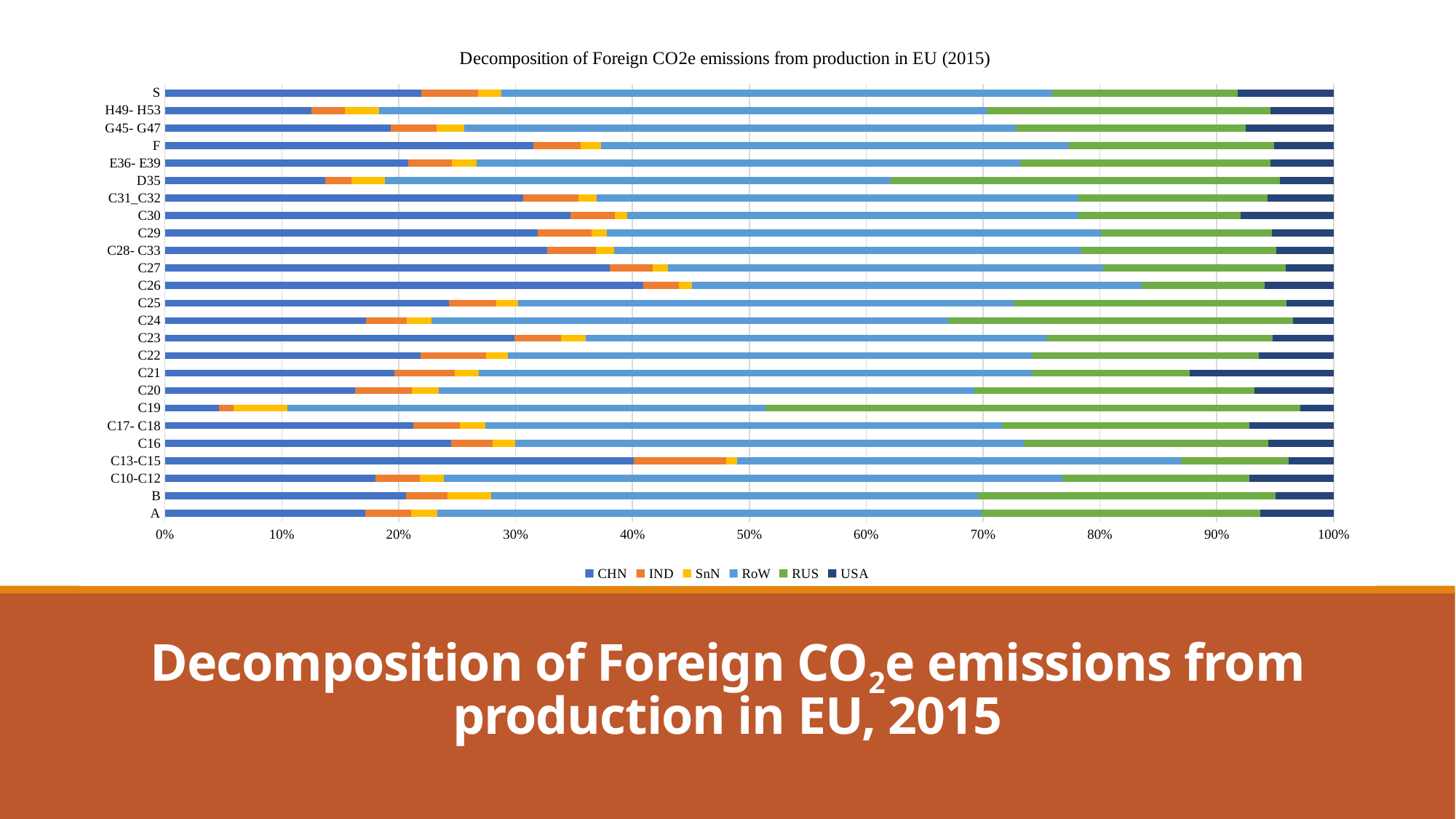
Which category has the largest RUS share? C19 Which series is shown in green in the legend? RUS Which has the larger CHN share, C19 or A? A How many categories (bars) are plotted on the chart? 25 Is the CHN share for C19 greater or less than 10%? less How many series does the legend list? 6 What kind of chart is shown on the slide? Stacked bar chart Is the CHN share for C27 greater or less than 30%? greater Which has the larger RUS share, D35 or C27? D35 Which category has the smallest CHN share? C19 What is the title of the chart? Decomposition of Foreign CO2e emissions from production in EU (2015) Is the CHN share for D35 greater or less than 20%? less